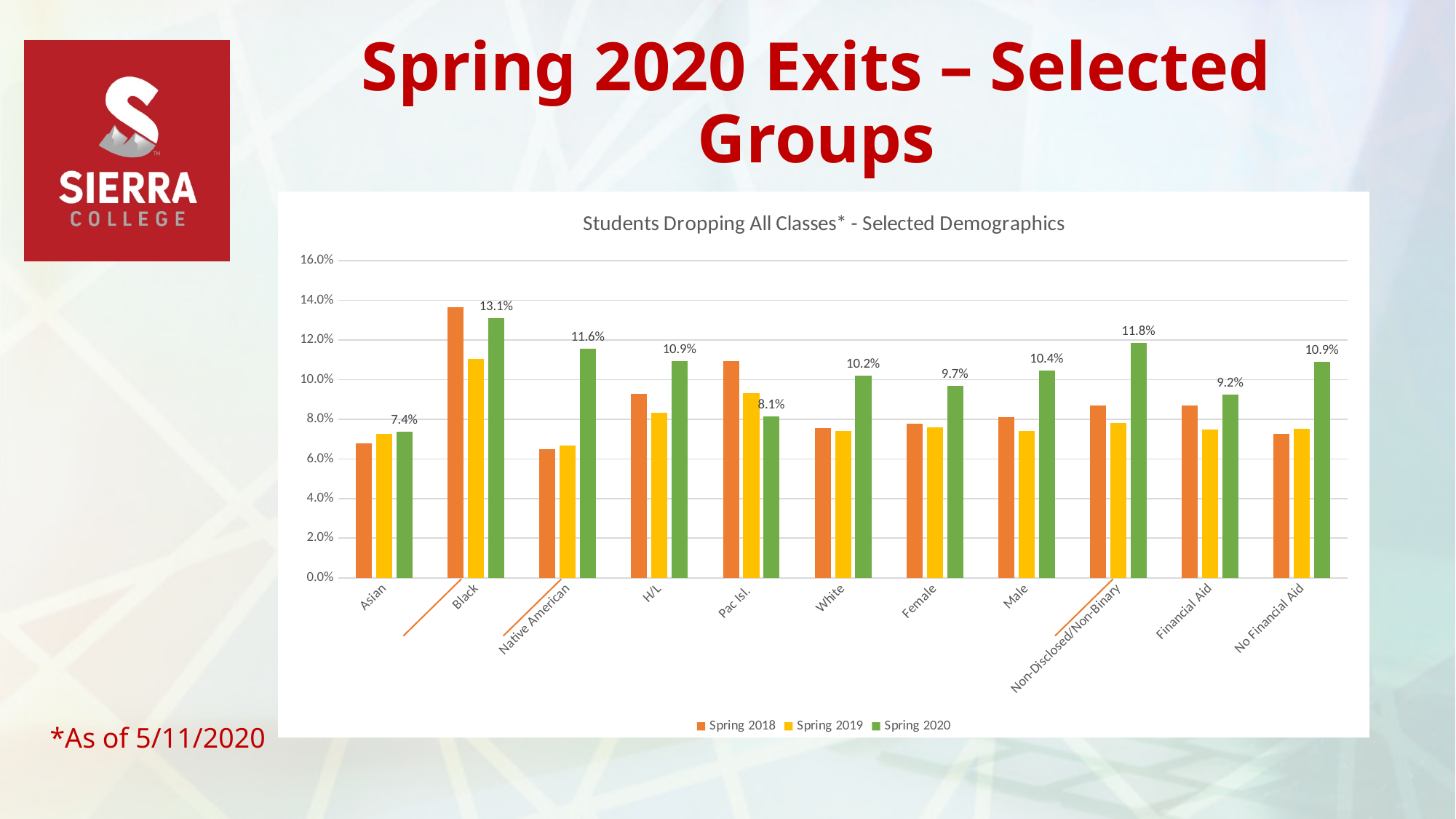
Which category has the highest Spring 2020 value? Black What is the difference between the Spring 2020 values for Black and Asian students? 5.7% Which category has the lowest Spring 2020 value? Asian What is the Spring 2020 value for Black students? 13.1% Is the Spring 2019 value for Asian students greater or less than 8.0%? less How many series does the legend list? 3 What is the Spring 2020 value for Financial Aid students? 9.2% What kind of chart is shown? Bar chart Is the Spring 2018 value for Black students greater or less than 12.0%? greater Which is larger for Spring 2020: Male or Female? Male What is the Spring 2020 value for Native American students? 11.6% How many categories are shown on the x axis? 11